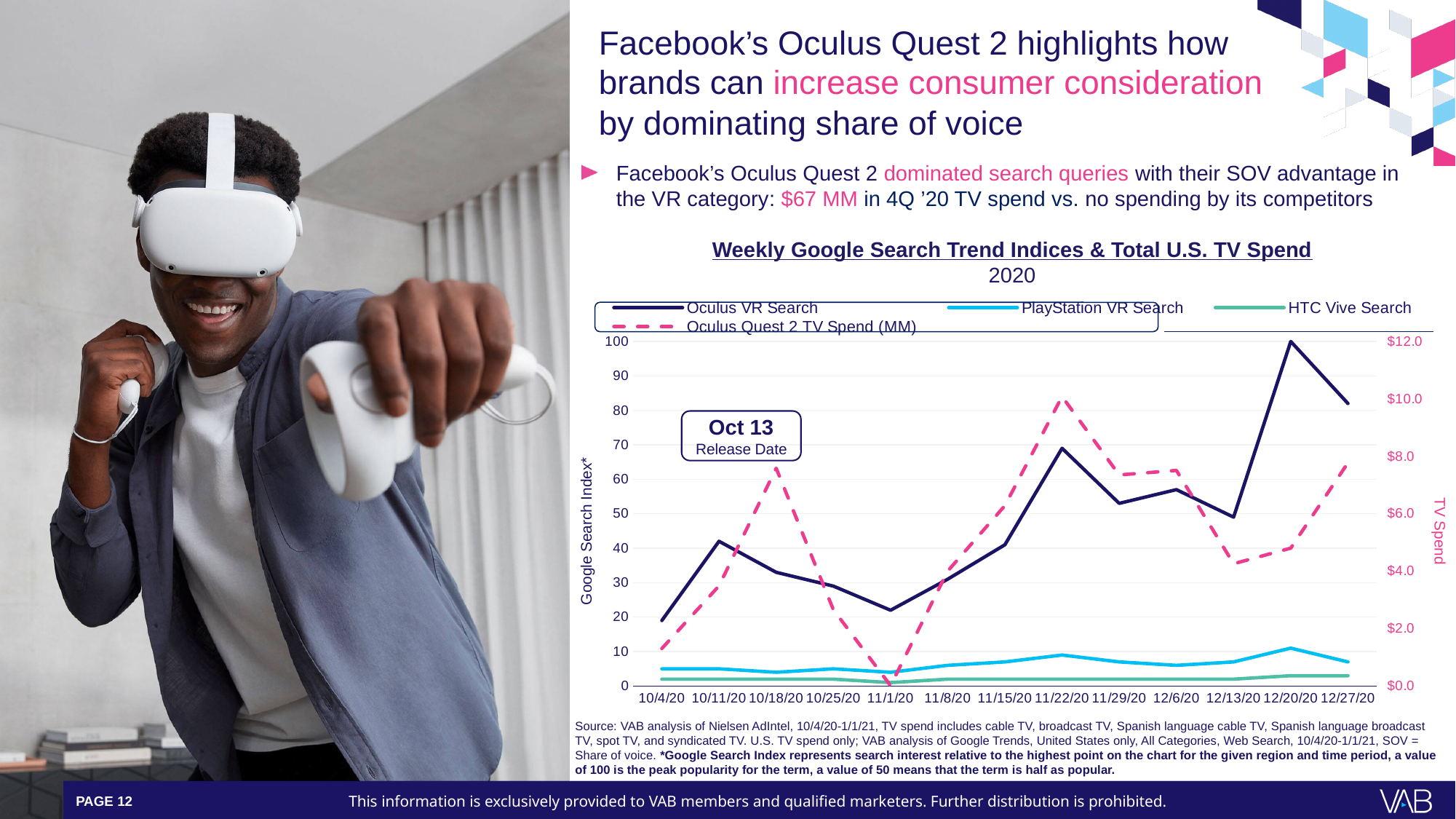
What kind of chart is shown on the slide? line chart On 12/20/20, which is larger: the Oculus VR Search index or the PlayStation VR Search index? Oculus VR Search Is the Oculus Quest 2 TV Spend on 10/18/20 greater or less than $6.0? greater Is the Oculus VR Search index on 11/22/20 greater or less than 60? greater What release date is annotated on the chart? Oct 13 Is the Oculus Quest 2 TV Spend on 11/1/20 greater or less than $2.0? less What is the Oculus VR Search index value on 12/20/20? 100 On which date does the Oculus VR Search index reach its highest value? 12/20/20 How many weekly dates are shown on the x axis of the chart? 13 On which date is Oculus Quest 2 TV Spend (MM) at its highest? 11/22/20 How many series does the chart legend list? 4